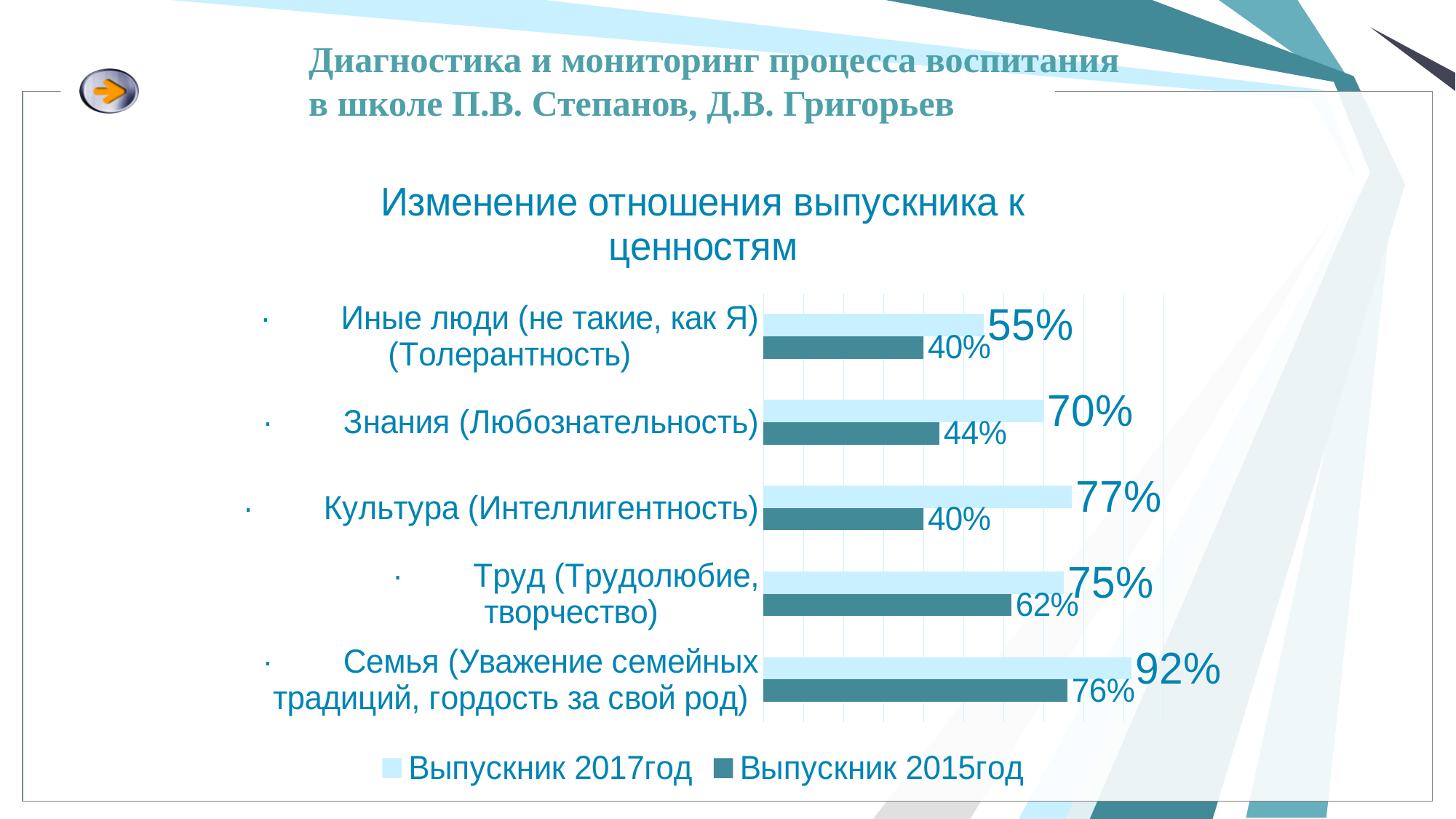
What is the difference between the Выпускник 2017год and Выпускник 2015год values for Культура (Интеллигентность)? 37% What kind of chart is shown on the slide? Bar chart How many categories are shown in the chart? 5 Which series is shown in the darker teal colour? Выпускник 2015год Which is larger for Знания (Любознательность): the Выпускник 2017год value or the Выпускник 2015год value? Выпускник 2017год Which category has the highest value for Выпускник 2017год? Семья (Уважение семейных традиций, гордость за свой род) What is the value for Выпускник 2015год for Труд (Трудолюбие, творчество)? 62% What is the value for Выпускник 2015год for Знания (Любознательность)? 44% What is the value for Выпускник 2017год for Семья (Уважение семейных традиций, гордость за свой род)? 92% What is the title of the chart? Изменение отношения выпускника к ценностям How many series does the legend list? 2 Which category has the lowest value for Выпускник 2017год? Иные люди (не такие, как Я) (Толерантность)